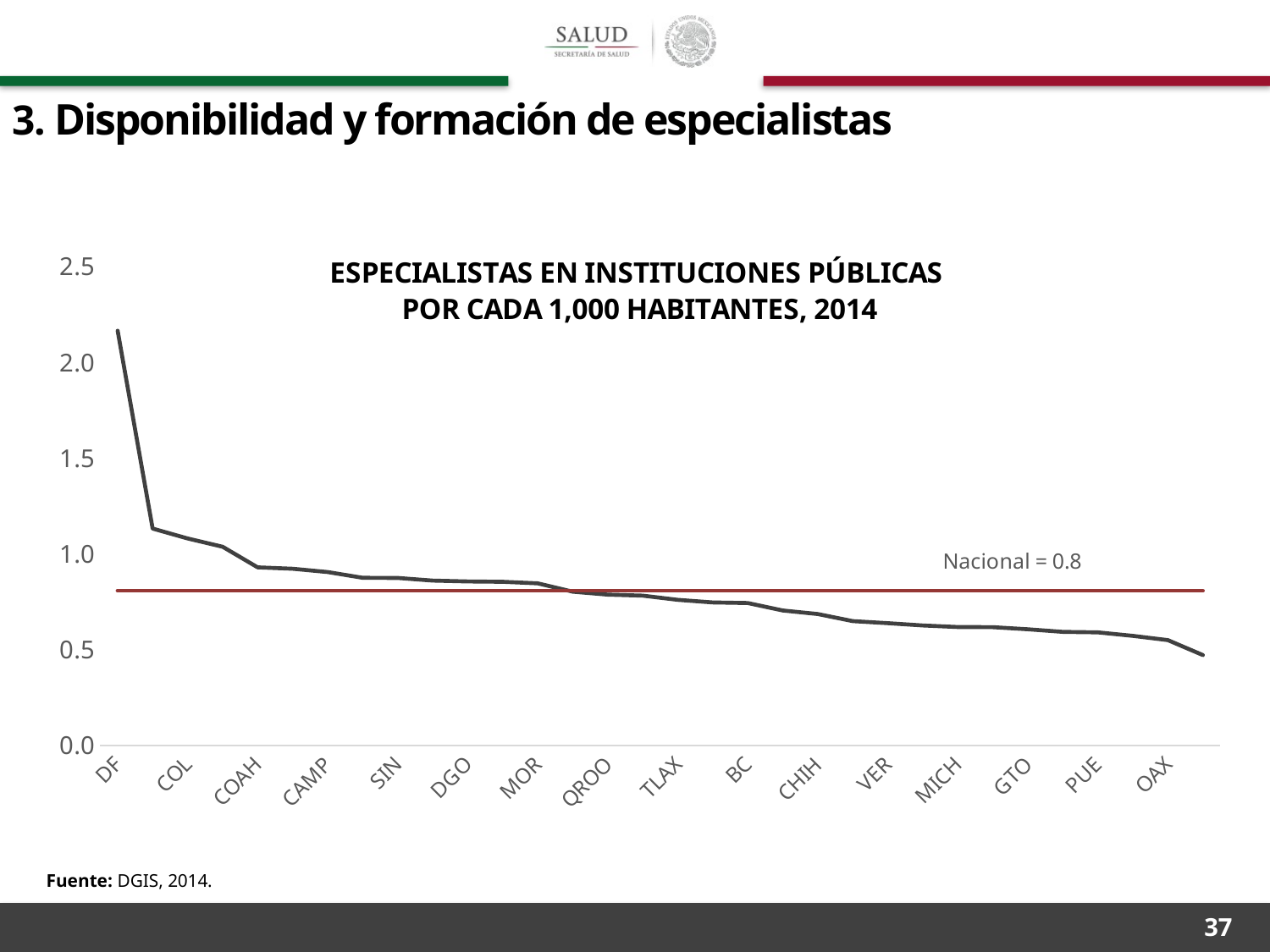
What kind of chart is shown on the slide? line chart What is the title of the chart? ESPECIALISTAS EN INSTITUCIONES PÚBLICAS POR CADA 1,000 HABITANTES, 2014 Is the value for VER greater or less than 1.0? less Do the values rise or fall moving from left to right along the x axis? fall Is the value for COL greater or less than 1.0? greater Which has a higher value, DF or COL? DF What is the national (Nacional) value shown by the horizontal reference line? 0.8 Which state has the highest number of specialists per 1,000 inhabitants? DF Is the value for DF greater or less than 2.0? greater Which has a higher value, COL or OAX? COL